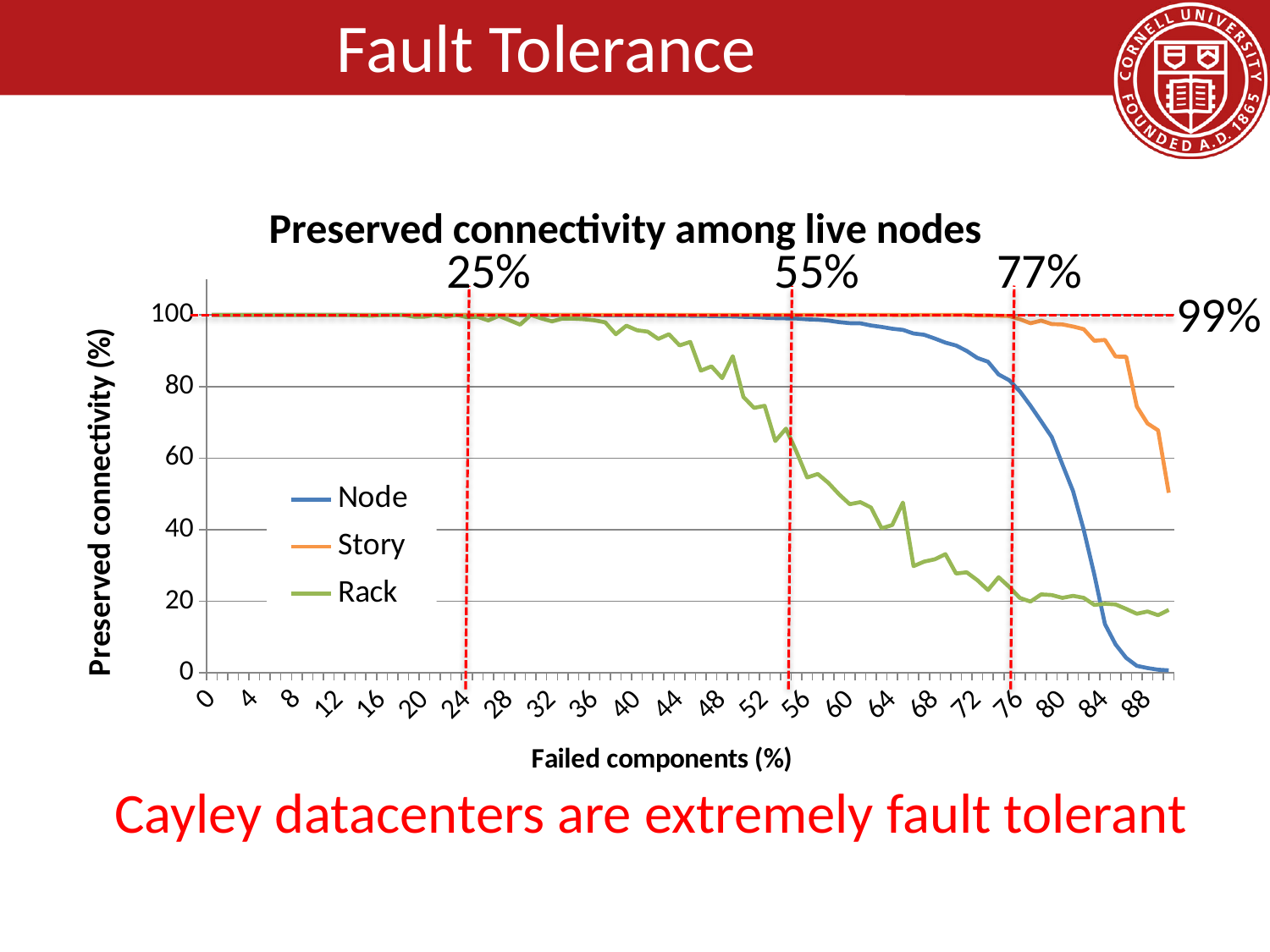
Does the Rack series rise or fall as failed components increase along the x axis? fall Is the value of the Node series at 80 failed components greater or less than 40? greater What kind of chart is shown on the slide? line chart What is the title of the chart? Preserved connectivity among live nodes At 80 failed components, which series has the larger value, Story or Node? Story Is the value of the Rack series at 60 failed components greater or less than 60? less Is the value of the Node series at 88 failed components greater or less than 20? less What is the label of the x axis? Failed components (%) How many series does the legend list? 3 At 40 failed components, which series has the larger value, Rack or Node? Node